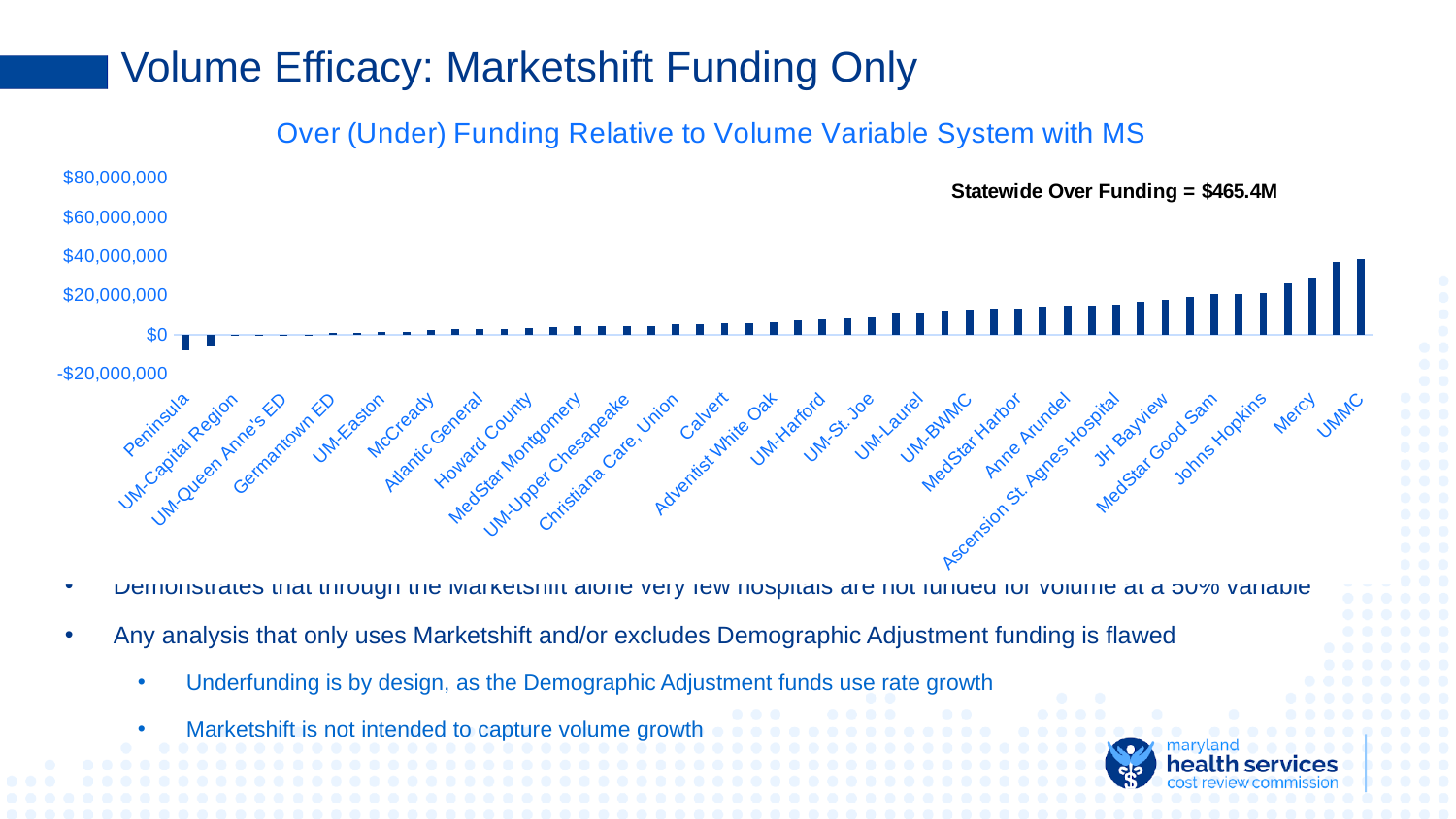
Is the value for Peninsula greater or less than $0? less Is the value for UMMC greater or less than $60,000,000? less What kind of chart is shown on the slide? bar chart Which has the larger value, UMMC or Peninsula? UMMC Which hospital has the lowest over (under) funding value in the chart? Peninsula Do the bar values generally rise or fall moving from left to right along the x axis? rise Which hospital has the highest over (under) funding value in the chart? UMMC What is the title of the chart? Over (Under) Funding Relative to Volume Variable System with MS What statewide over funding figure is annotated on the chart? $465.4M Is the value for UMMC greater or less than $20,000,000? greater